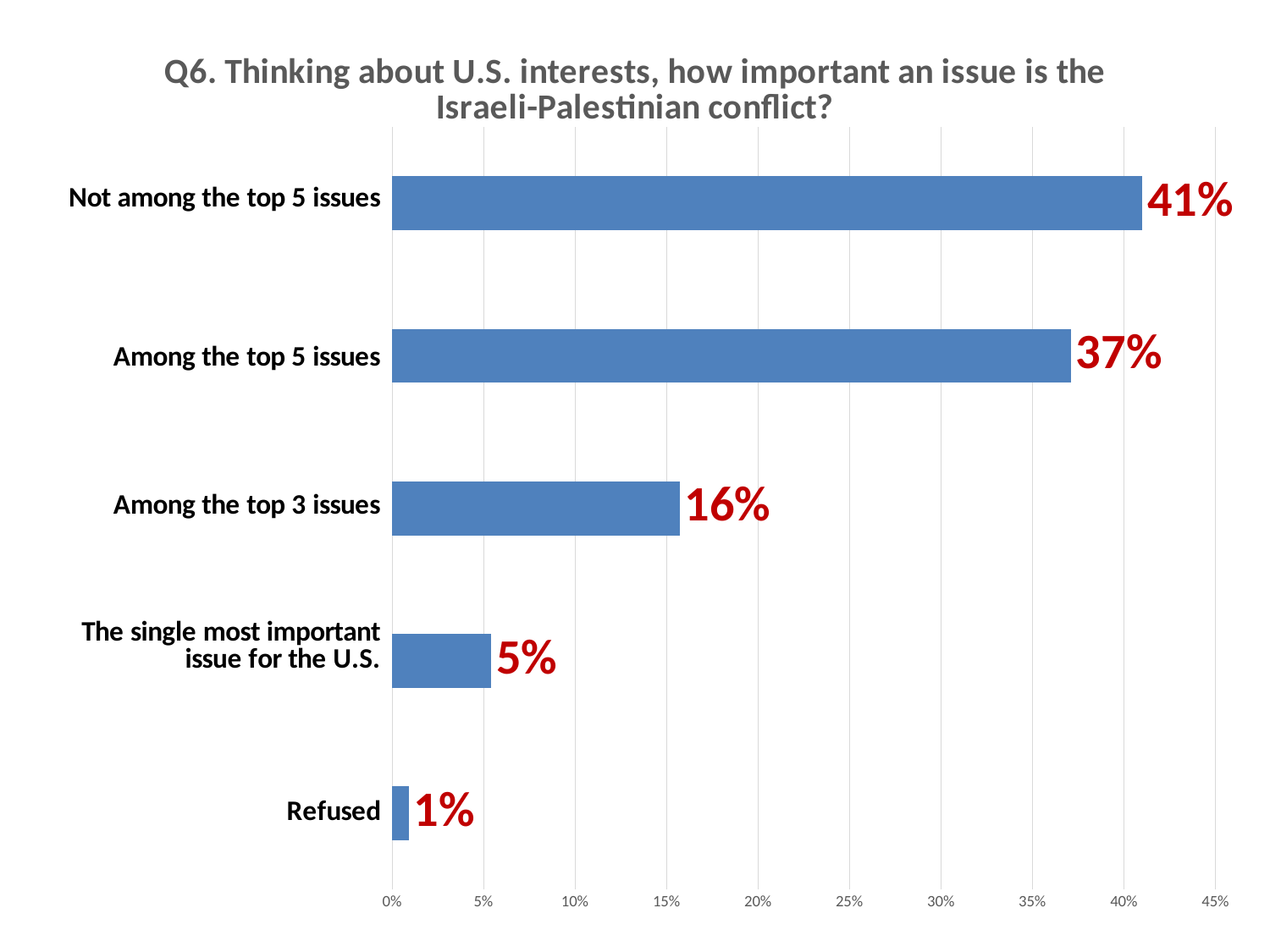
What percentage of respondents said the Israeli-Palestinian conflict is not among the top 5 issues? 41% Which category has the lowest value? Refused What is the value for "Among the top 3 issues"? 16% How many categories are shown in the chart? 5 What is the value for "Refused"? 1% What is the highest value shown on the horizontal axis? 45% What kind of chart is shown on the slide? Bar chart Which category has the highest value? Not among the top 5 issues What percentage said it is the single most important issue for the U.S.? 5% Which is larger: the value for "Among the top 3 issues" or "The single most important issue for the U.S."? Among the top 3 issues What is the difference between "Among the top 5 issues" and "Among the top 3 issues"? 21% What is the difference between "Not among the top 5 issues" and "Among the top 5 issues"? 4%